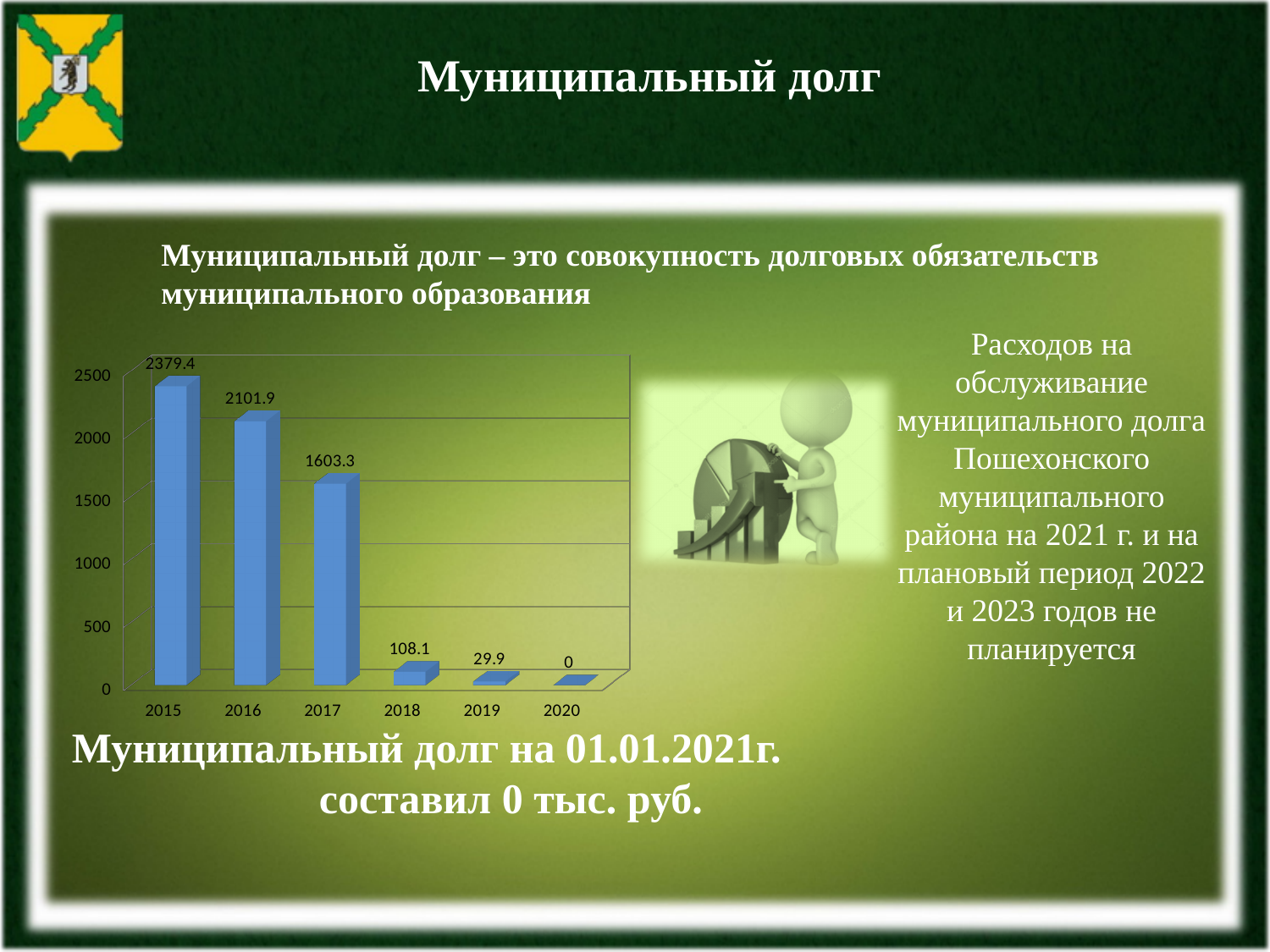
What kind of chart is shown on the slide? bar chart What is the value for 2015? 2379.4 Which year has the lowest value? 2020 What is the value for 2019? 29.9 How many years are shown on the x axis? 6 Do the values rise or fall from 2015 to 2020? fall What is the difference between the values for 2015 and 2016? 277.5 Which is larger, the value for 2016 or the value for 2017? 2016 What is the value for 2020? 0 What is the difference between the values for 2018 and 2019? 78.2 What is the value for 2017? 1603.3 Which year has the highest value? 2015